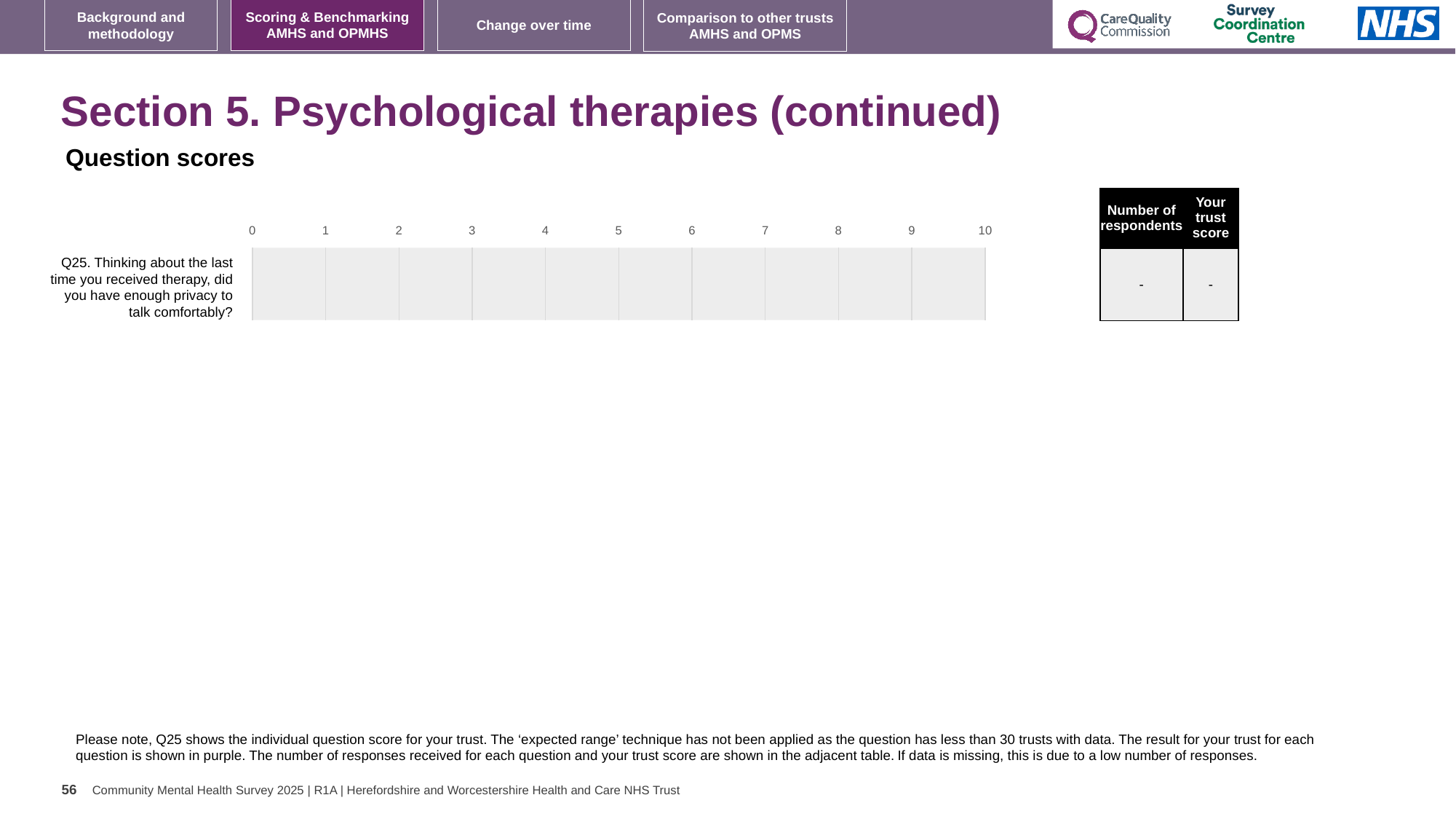
How many questions (categories) are listed on the chart? 1 What is the lowest value shown on the chart's horizontal axis? 0 What value is shown in the 'Number of respondents' column of the table for Q25? - What is the highest value shown on the chart's horizontal axis? 10 Which question number is shown on the chart? Q25 Is a bar plotted for Q25 on the chart? No What value is shown in the 'Your trust score' column of the table for Q25? -